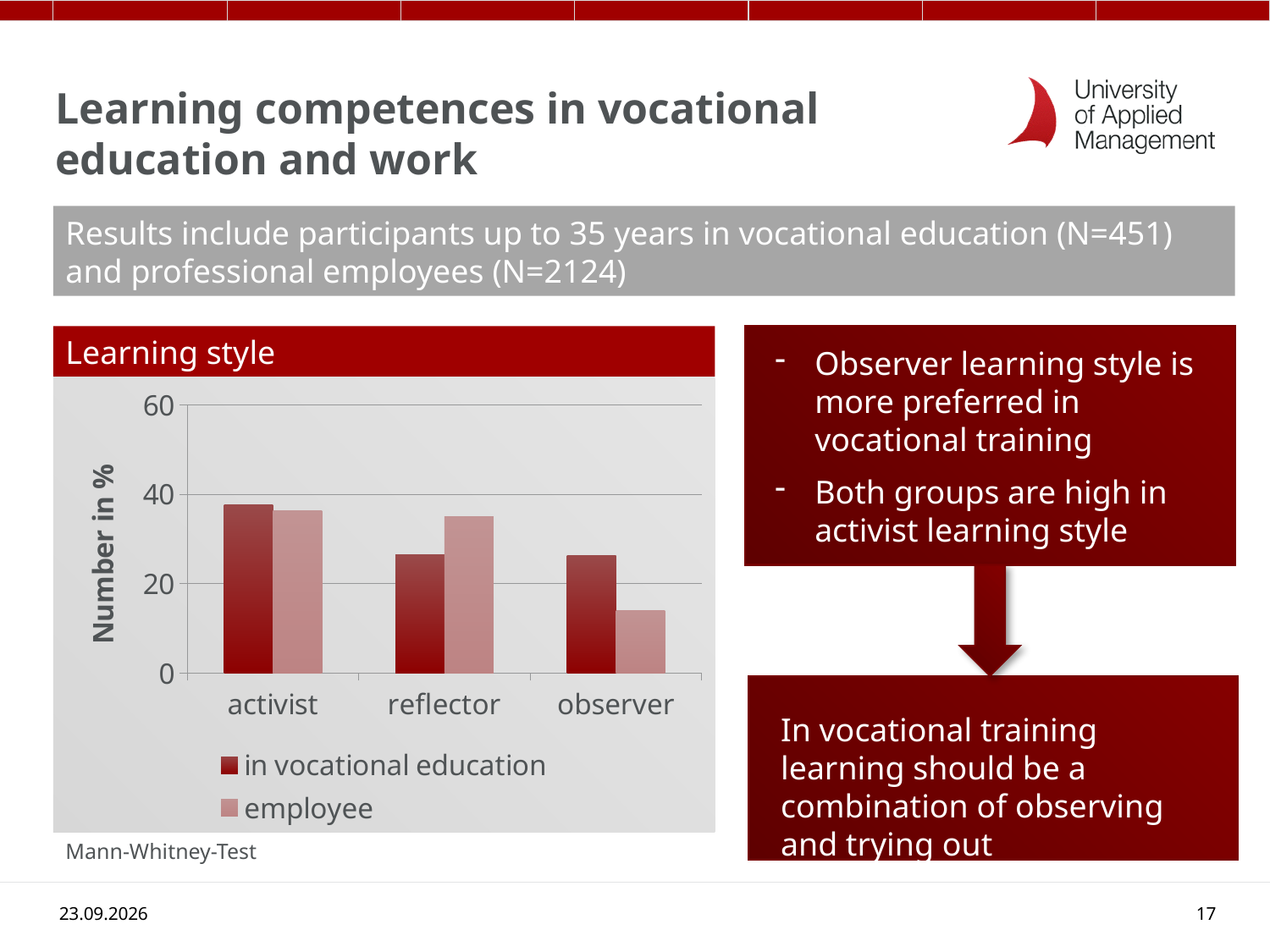
How many series does the legend of the "Learning style" chart list? 2 Is the value for "reflector" in the "employee" series greater or less than 40? less Which two series are listed in the legend of the "Learning style" chart? in vocational education, employee Which learning style has the highest value in the "in vocational education" series? activist What kind of chart is shown under the heading "Learning style"? bar chart Is the value for "observer" in the "employee" series greater or less than 20? less For "reflector", which series has the larger value: "in vocational education" or "employee"? employee For "observer", which series has the larger value: "in vocational education" or "employee"? in vocational education What is the label of the vertical axis of the "Learning style" chart? Number in % How many learning style categories are shown on the x axis of the chart? 3 Is the value for "observer" in the "in vocational education" series greater or less than 20? greater